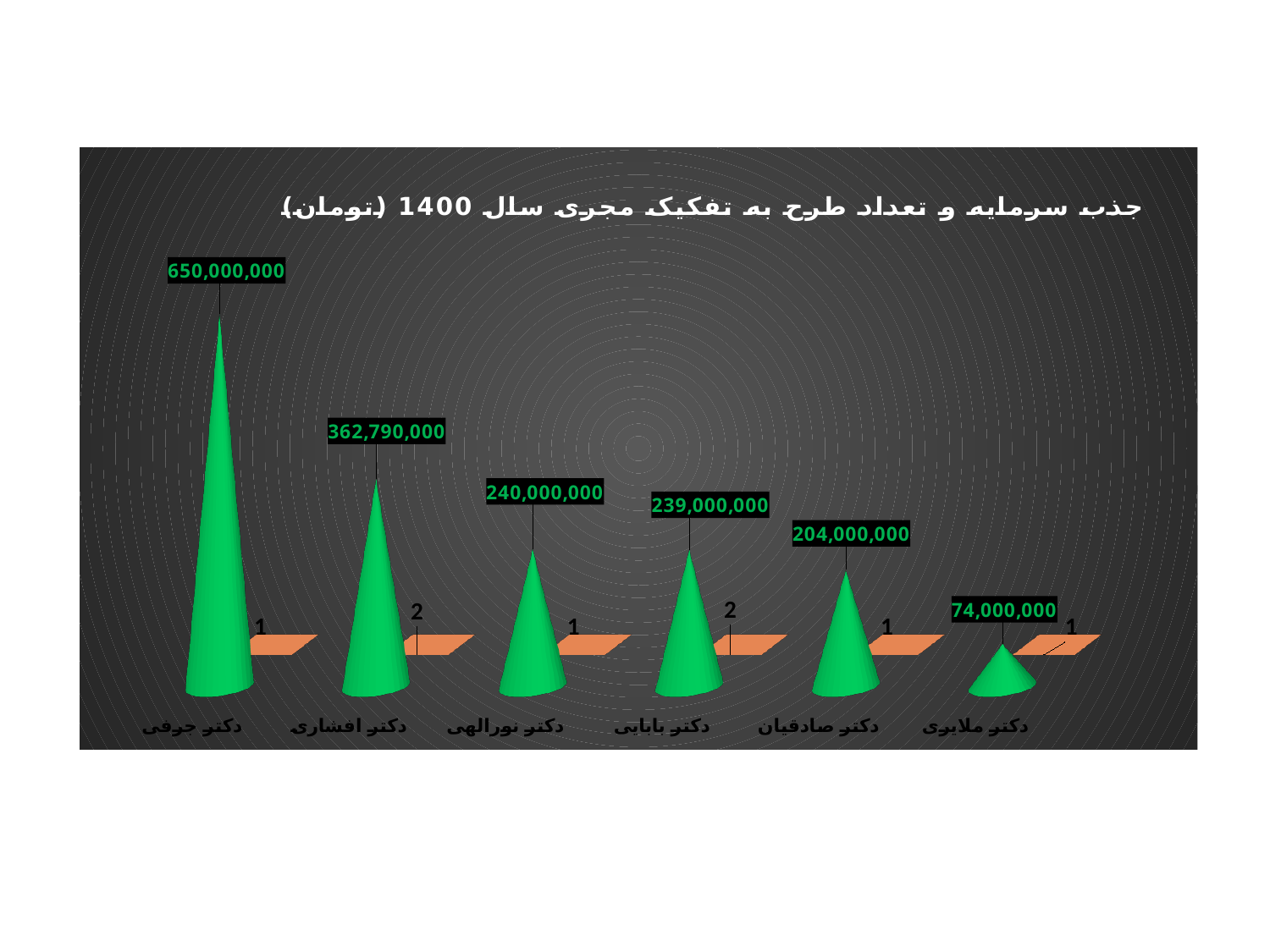
What is the difference between the investment values of دکتر نورالهی and دکتر بابایی? 1,000,000 How many executors (categories) are shown on the chart? 6 What is the title of the chart? جذب سرمایه و تعداد طرح به تفکیک مجری سال 1400 (تومان) Which executor has the highest investment value? دکتر جرفی Which executor has the lowest investment value? دکتر ملایری How many projects are shown for دکتر بابایی? 2 What is the investment value shown for دکتر افشاری? 362,790,000 What kind of chart is shown on the slide? Bar chart